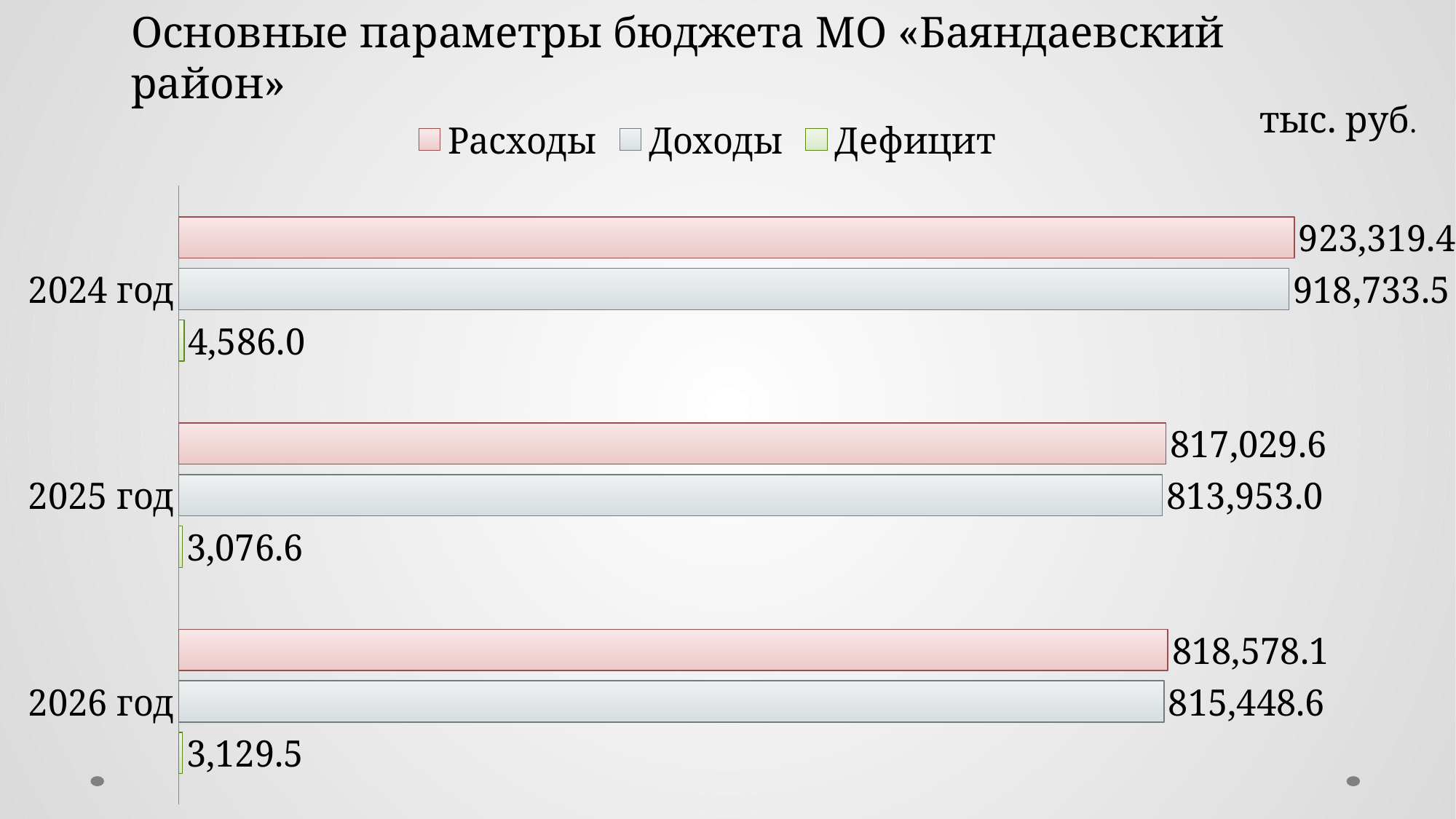
Does the Доходы value rise or fall from 2024 год to 2025 год? Fall How many series does the legend list? 3 Which year has the lowest Дефицит value? 2025 год Which is larger for 2026 год: Расходы or Доходы? Расходы What is the difference between Расходы and Доходы for 2025 год? 3,076.6 What is the value of Расходы for 2024 год? 923,319.4 What kind of chart is shown on the slide? Bar chart How many years (categories) are shown on the chart? 3 What is the value of Дефицит for 2026 год? 3,129.5 What unit is indicated in the top right corner of the chart? тыс. руб. Which year has the highest Расходы value? 2024 год What is the value of Доходы for 2025 год? 813,953.0